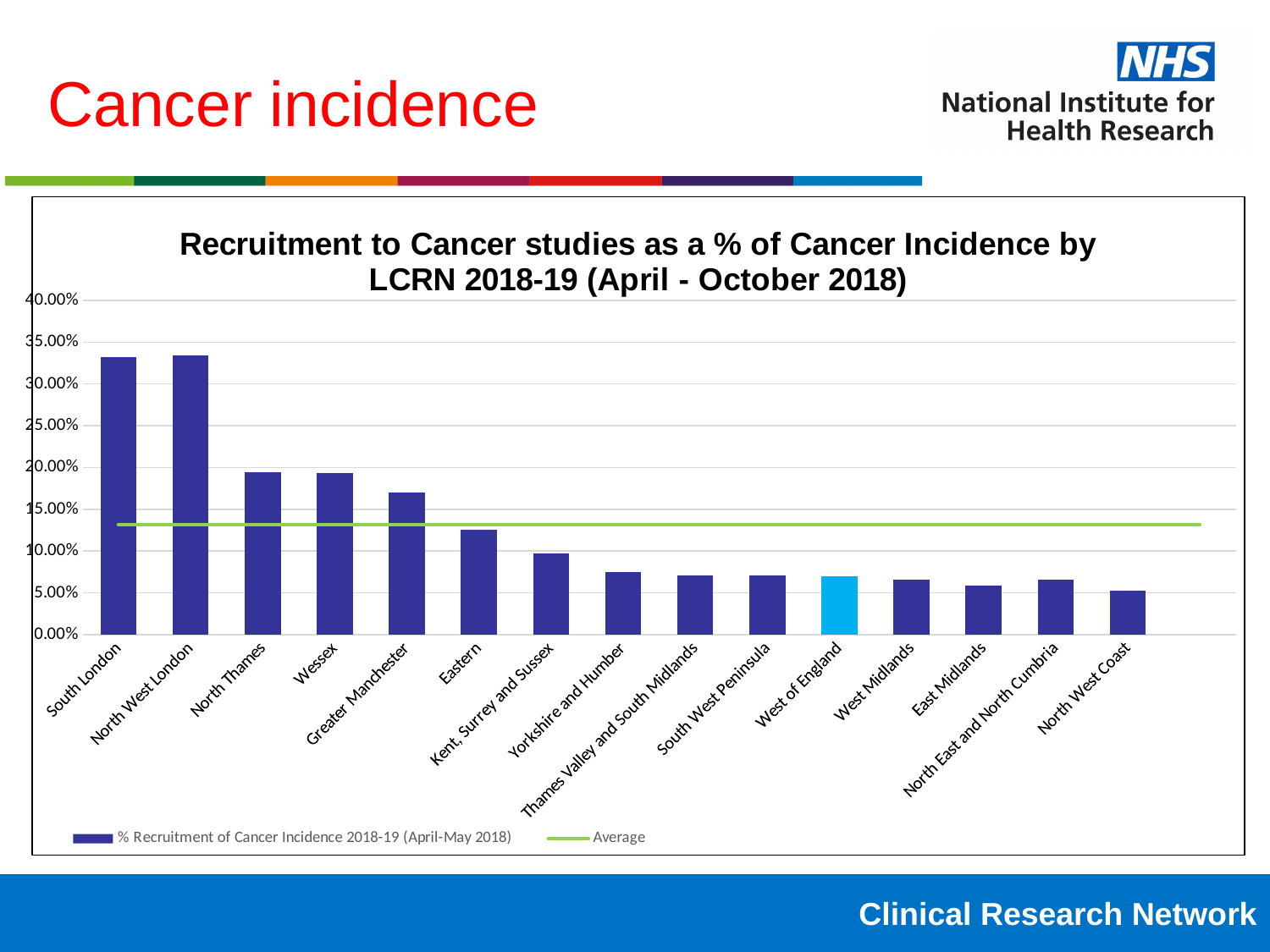
How many entries does the legend list? 2 Is the value for Eastern greater or less than 15.00%? less Is the value for Yorkshire and Humber greater or less than 10.00%? less Do the bar values generally rise or fall moving from left to right along the x axis? fall Is the value for West of England greater or less than 5.00%? greater Which LCRN has the lowest recruitment as a % of cancer incidence? North West Coast How many LCRN categories are plotted along the x axis? 15 Which has the larger value, Wessex or Eastern? Wessex What kind of chart is shown on the slide? bar chart Which LCRN's bar is shown in a lighter blue colour than the others? West of England